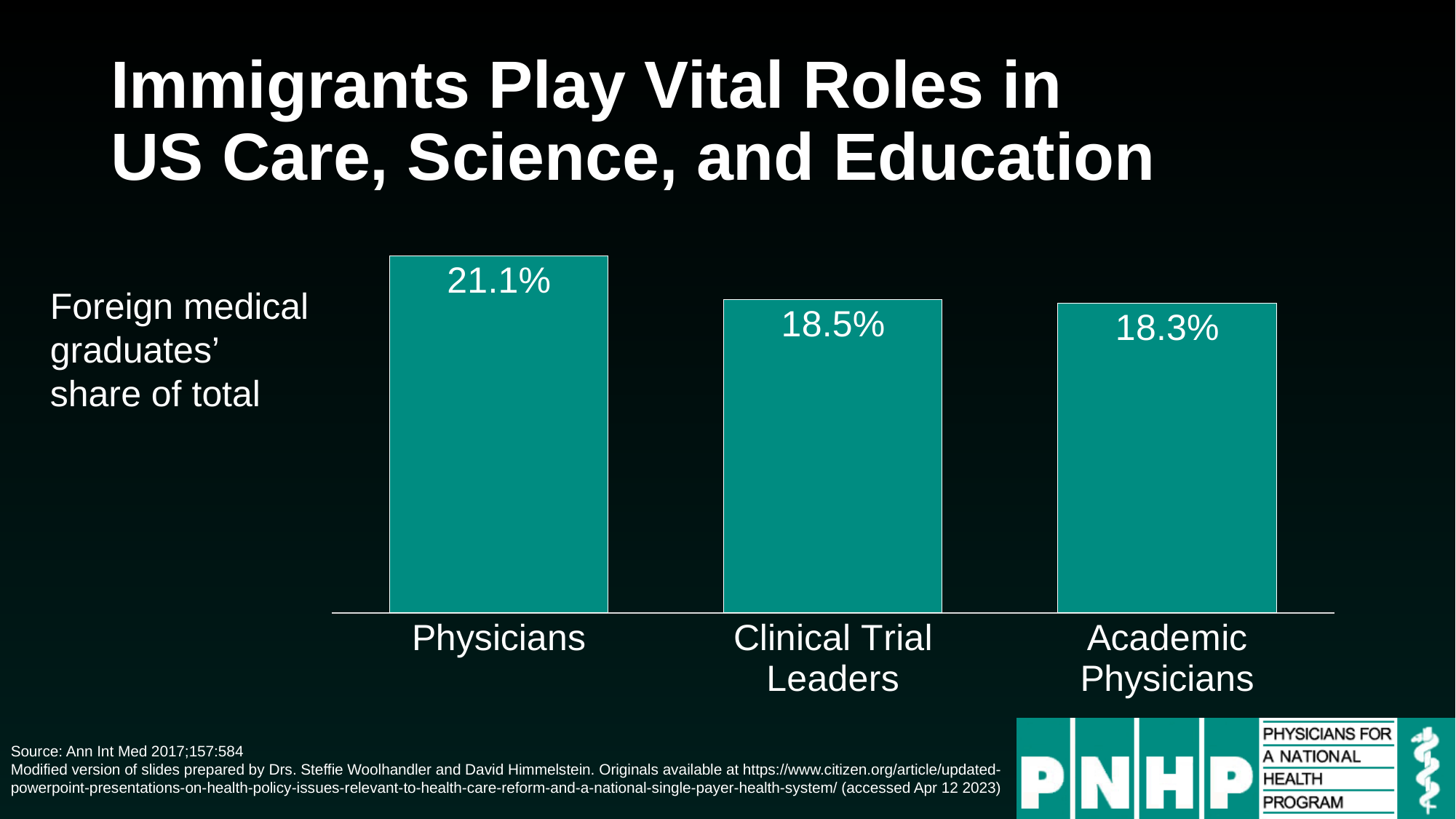
What is the foreign medical graduates' share of total for Academic Physicians? 18.3% What is the difference in percentage points between the Physicians bar and the Clinical Trial Leaders bar? 2.6 Which category has the lowest foreign medical graduates' share? Academic Physicians What kind of chart is shown on the slide? Bar chart What is the foreign medical graduates' share of total for Clinical Trial Leaders? 18.5% What quantity does the chart show, according to the label to the left of the bars? Foreign medical graduates' share of total Do the values rise or fall from left to right across the categories? Fall What is the difference in percentage points between the Physicians bar and the Academic Physicians bar? 2.8 What is the foreign medical graduates' share of total for Physicians? 21.1% Which category has the highest foreign medical graduates' share? Physicians How many categories are shown in the chart? 3 Which is larger, the value for Clinical Trial Leaders or the value for Academic Physicians? Clinical Trial Leaders